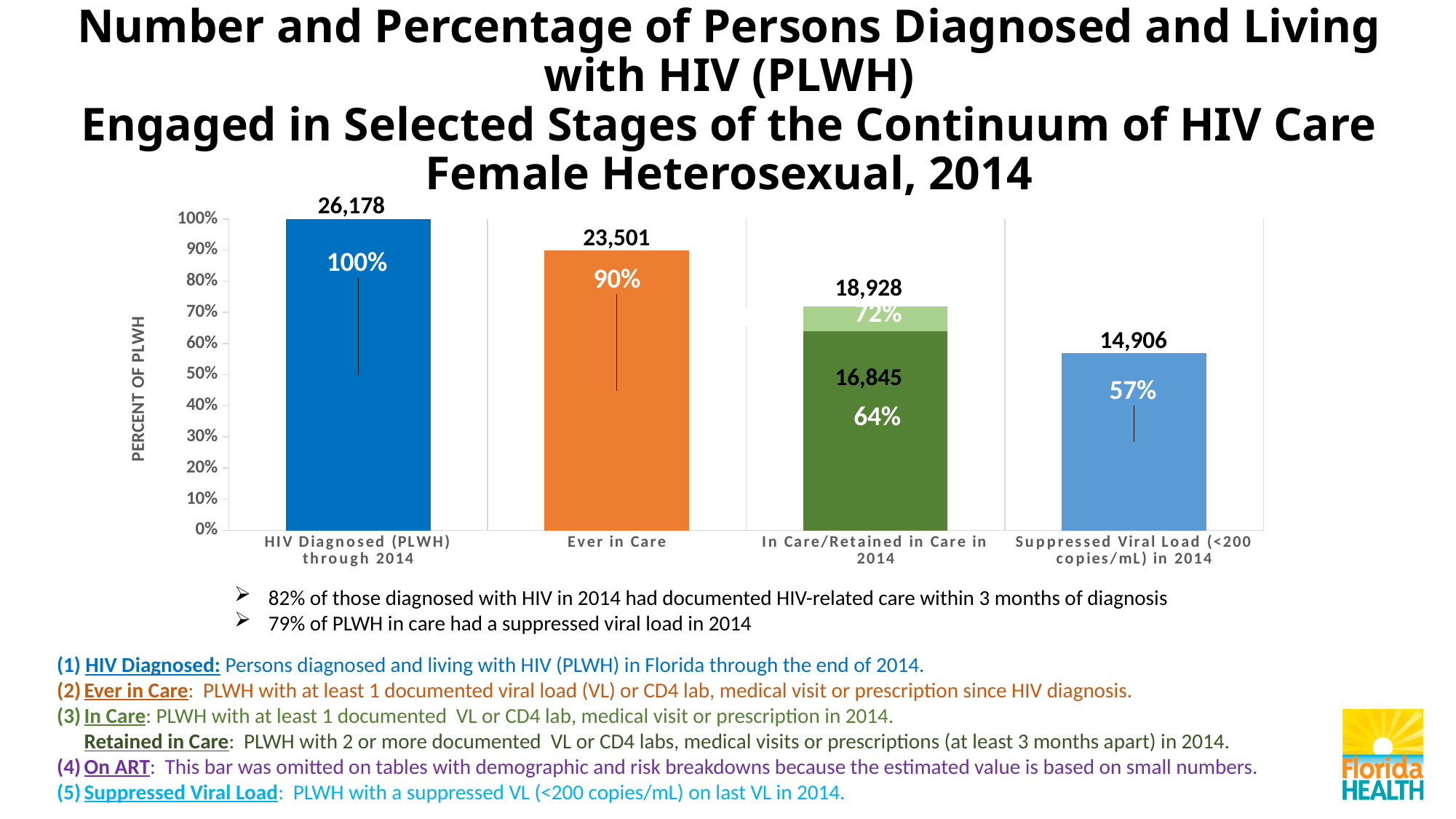
What is the difference in number of persons between HIV Diagnosed (PLWH) through 2014 and Ever in Care? 2,677 What number is labelled at the top of the In Care/Retained in Care in 2014 bar? 18,928 Which is larger: the percentage for Ever in Care or the percentage for Suppressed Viral Load (<200 copies/mL) in 2014? Ever in Care What kind of chart is shown on the slide? bar chart What number is labelled on the Suppressed Viral Load (<200 copies/mL) in 2014 bar? 14,906 How many categories are shown along the x axis of the chart? 4 What percentage is shown on the Ever in Care bar? 90% Which category has the highest number of persons? HIV Diagnosed (PLWH) through 2014 Which category has the lowest percentage of PLWH? Suppressed Viral Load (<200 copies/mL) in 2014 What percentage is shown for the dark green Retained in Care portion of the In Care/Retained in Care in 2014 bar? 64% What number is labelled on the bar for HIV Diagnosed (PLWH) through 2014? 26,178 Do the percentages rise or fall moving from left to right across the chart? fall